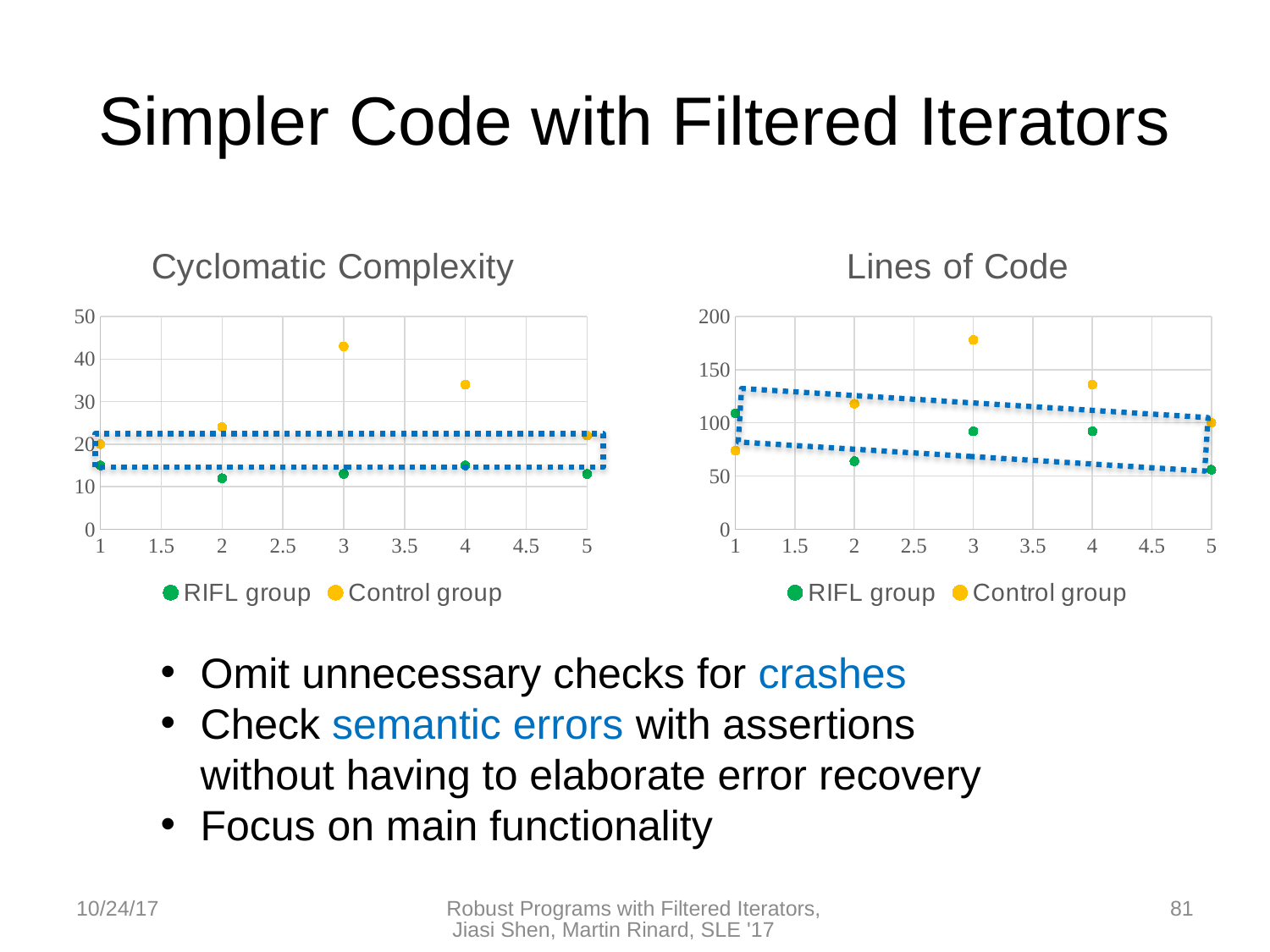
In the Cyclomatic Complexity chart, is the RIFL group value at x = 2 greater or less than 20? less In the Cyclomatic Complexity chart, at which x value does the Control group reach its highest point? 3 What kind of chart is the Cyclomatic Complexity chart? scatter chart In the Lines of Code chart, is the Control group value at x = 3 greater or less than 150? greater In the Lines of Code chart, at x = 1, which series has the larger value, RIFL group or Control group? RIFL group In the Lines of Code chart, at which x value does the Control group reach its highest point? 3 How many series does the legend of the Lines of Code chart list? 2 In the Cyclomatic Complexity chart, at x = 3, which series has the larger value, RIFL group or Control group? Control group In the Cyclomatic Complexity chart, is the Control group value at x = 3 greater or less than 40? greater In the Cyclomatic Complexity chart, how many points are plotted for the RIFL group? 5 What are the two legend entries in the Cyclomatic Complexity chart? RIFL group and Control group